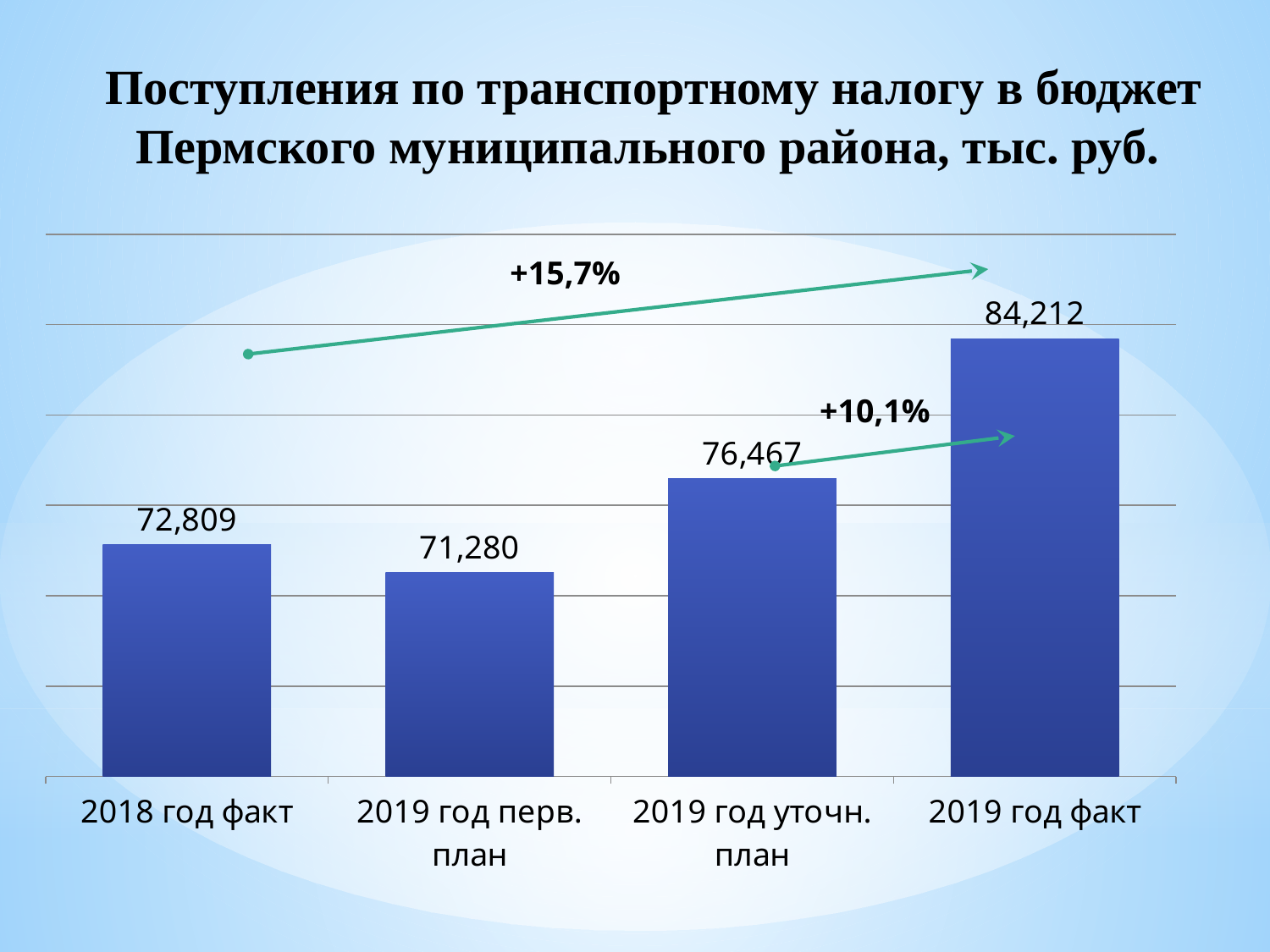
What percentage change is annotated between 2018 год факт and 2019 год факт? +15,7% Which category has the highest value? 2019 год факт What is the difference between the values for 2019 год уточн. план and 2019 год перв. план? 5,187 What is the value for 2019 год уточн. план? 76,467 What is the difference between the values for 2019 год факт and 2018 год факт? 11,403 What kind of chart is shown on the slide? Bar chart What is the value for 2018 год факт? 72,809 How many categories are shown in the chart? 4 Which is larger, the value for 2019 год уточн. план or the value for 2018 год факт? 2019 год уточн. план What is the value for 2019 год факт? 84,212 Which category has the lowest value? 2019 год перв. план What is the value for 2019 год перв. план? 71,280